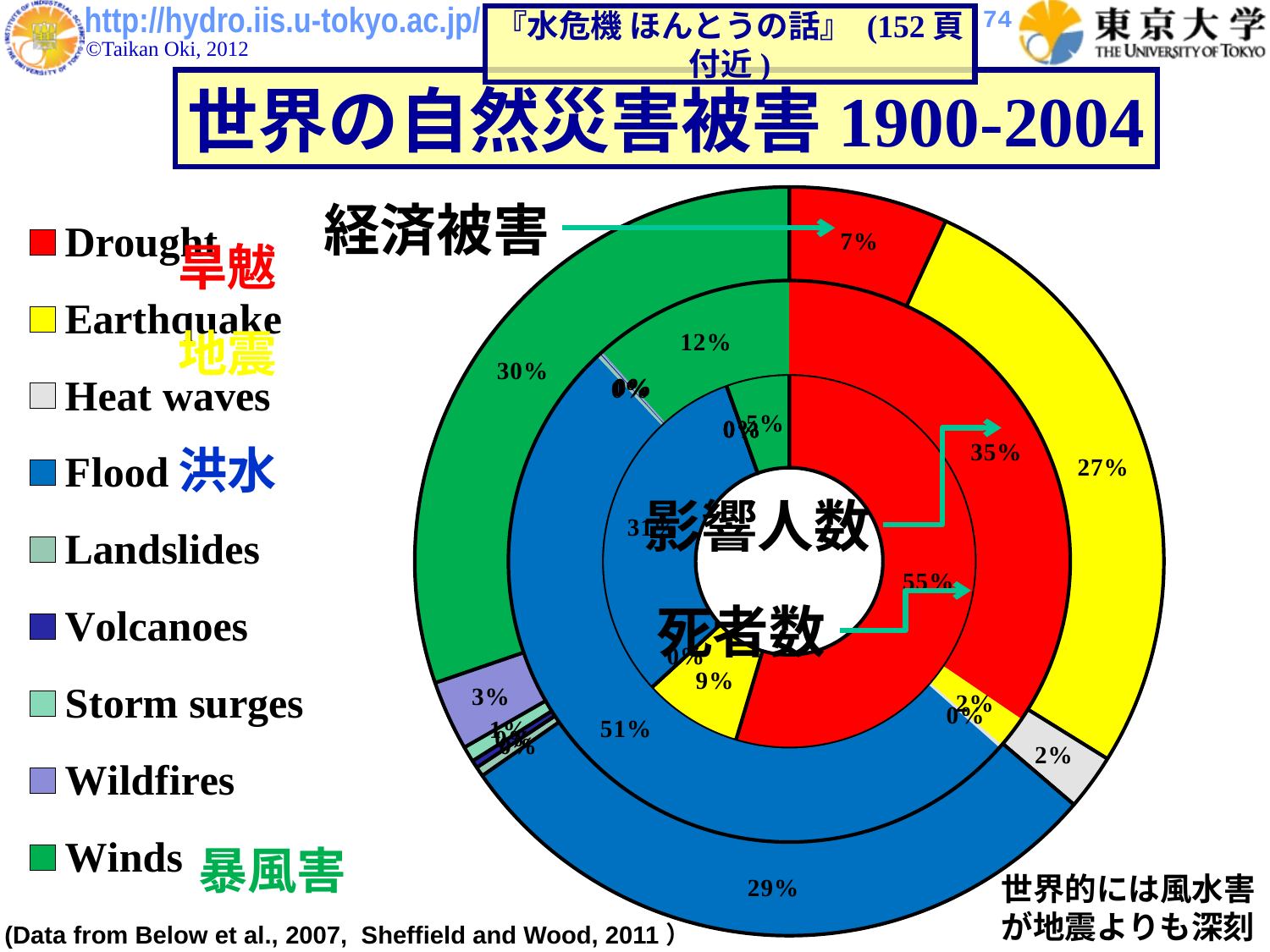
What kind of chart is shown on the slide? doughnut chart In the outer ring (経済被害), which is larger, the share for Earthquake or the share for Drought? Earthquake In the middle ring (影響人数), which category has the largest share? Flood In the outer ring (経済被害), what is the share for Winds? 30% In the middle ring (影響人数), what is the difference between the Flood share (51%) and the Drought share (35%)? 16% In the middle ring (影響人数), what is the share for Flood? 51% In the inner ring (死者数), what is the share for Drought? 55% In the inner ring (死者数), which category has the largest share? Drought How many categories does the legend list? 9 In the outer ring (経済被害), what is the share for Earthquake? 27% Which colour represents Flood in the chart? blue How many rings does the doughnut chart have? 3